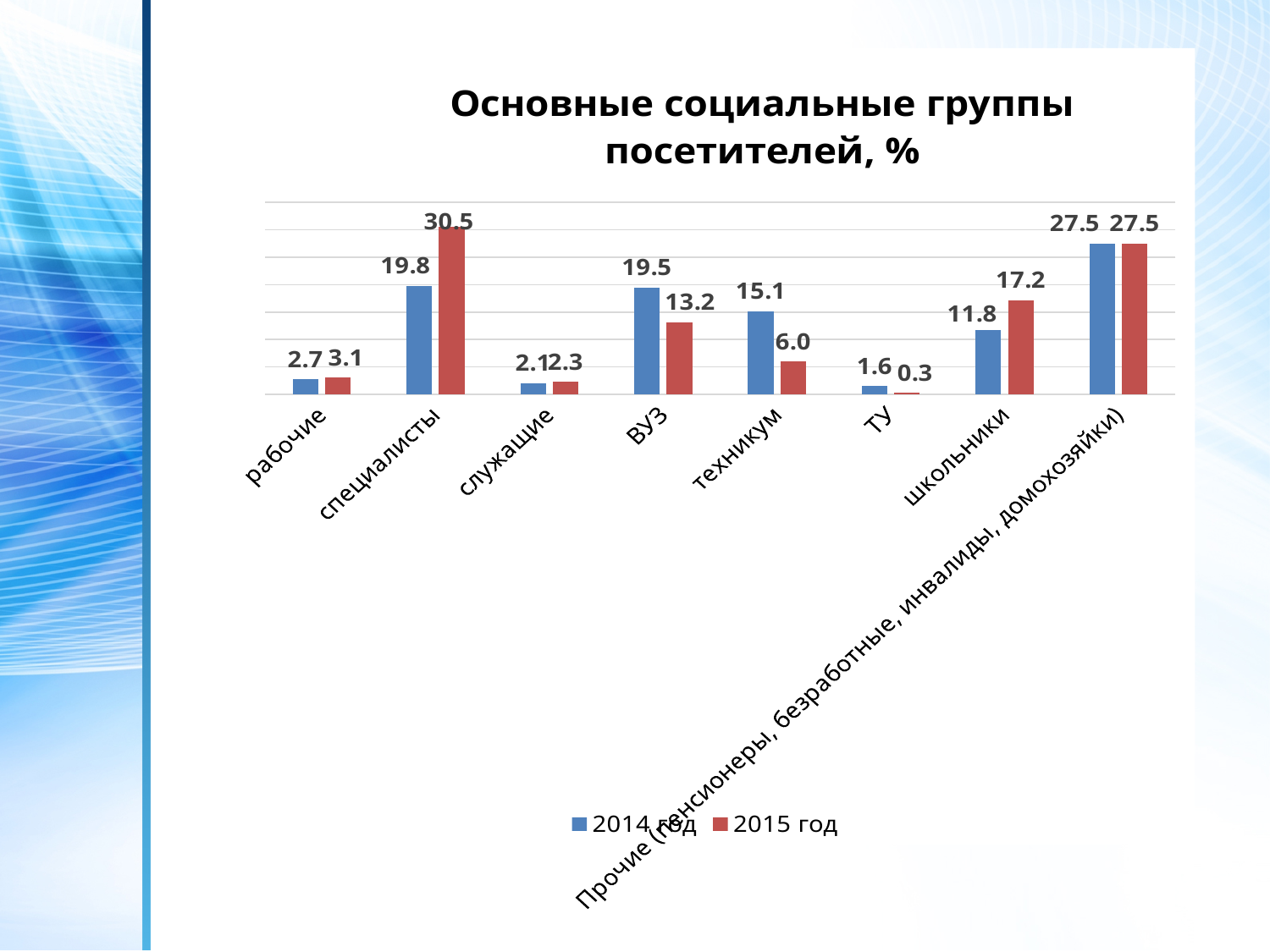
How many categories are shown on the x axis? 8 Which category has the highest value in the 2015 год series? специалисты What is the value for школьники in 2014 год? 11.8 Which category has the lowest value in the 2015 год series? ТУ What is the value for специалисты in 2015 год? 30.5 What is the value for техникум in 2015 год? 6.0 What is the difference between the 2015 год and 2014 год values for специалисты? 10.7 Which is larger for школьники: the 2014 год value or the 2015 год value? 2015 год What kind of chart is shown on the slide? bar chart How many series does the legend list? 2 What is the value for ВУЗ in 2014 год? 19.5 What is the difference between the 2014 год and 2015 год values for техникум? 9.1